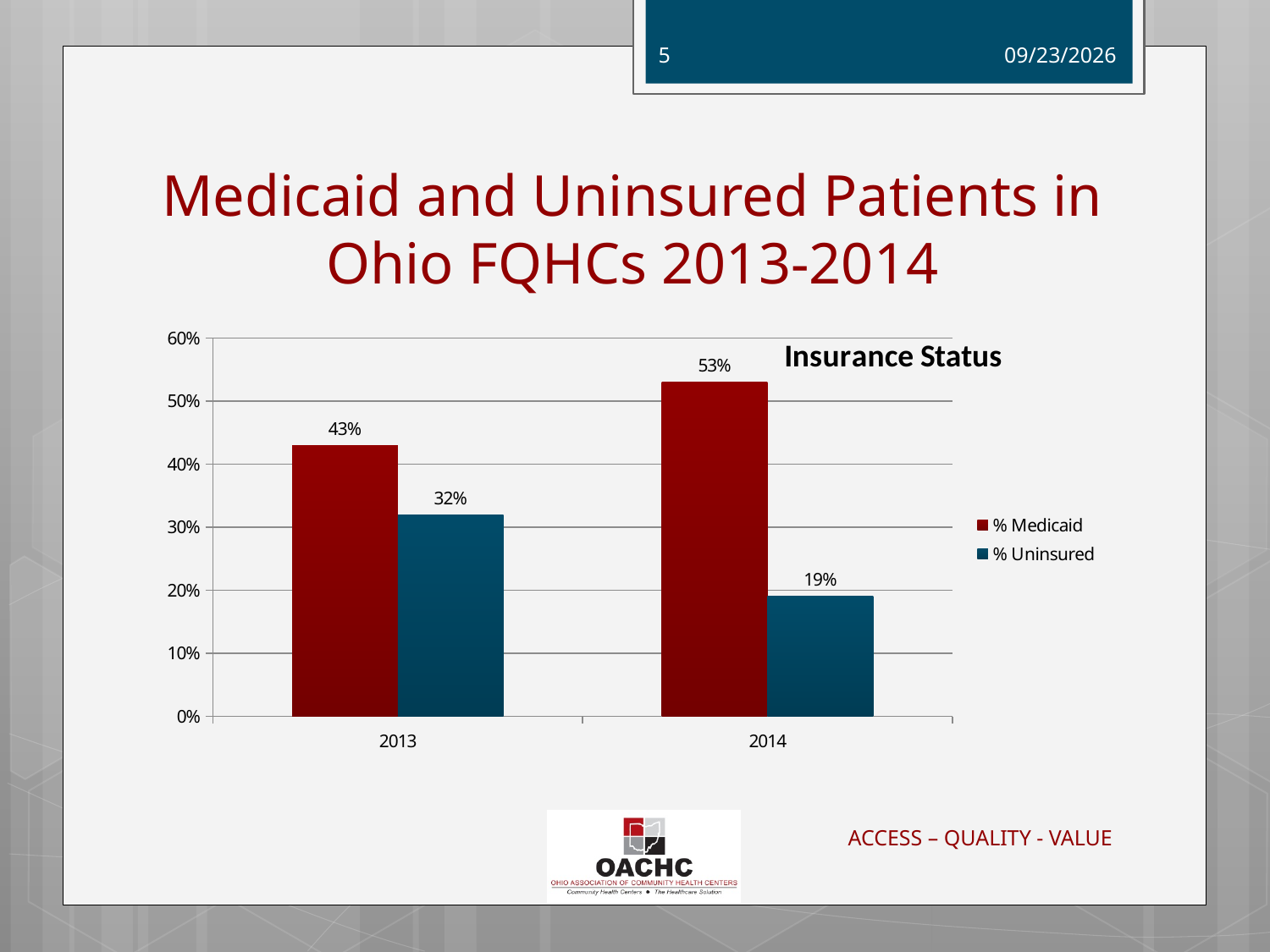
What is the difference between the % Uninsured values for 2013 and 2014? 13% What is the % Medicaid value for 2014? 53% Which year has the higher % Medicaid value? 2014 What is the % Medicaid value for 2013? 43% What kind of chart is shown on the slide? bar chart What is the % Uninsured value for 2013? 32% Is the % Uninsured value for 2013 larger or smaller than the % Medicaid value for 2013? smaller How many series does the legend list? 2 What is the title of the chart? Insurance Status Which year has the lower % Uninsured value? 2014 What is the % Uninsured value for 2014? 19% What is the difference between the % Medicaid values for 2014 and 2013? 10%